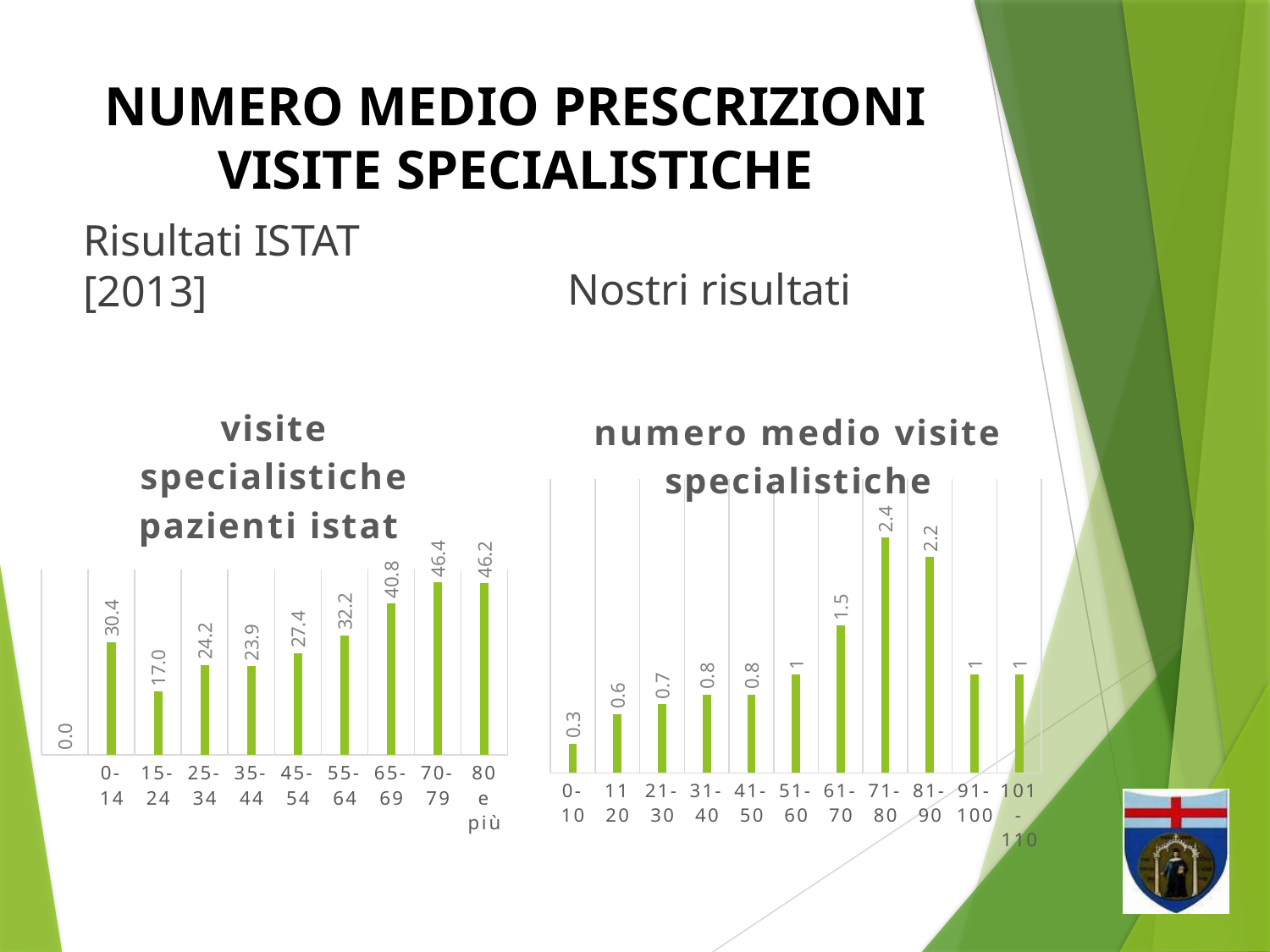
In the chart titled 'visite specialistiche pazienti istat', what is the value for the 0-14 age group? 30.4 In the chart titled 'numero medio visite specialistiche', what is the difference between the values for 71-80 and 81-90? 0.2 In the chart titled 'visite specialistiche pazienti istat', what is the value for the 65-69 age group? 40.8 What kind of chart is the chart titled 'numero medio visite specialistiche'? Bar chart In the chart titled 'numero medio visite specialistiche', what is the value for the 0-10 group? 0.3 In the chart titled 'numero medio visite specialistiche', what is the value for the 61-70 group? 1.5 In the chart titled 'visite specialistiche pazienti istat', what is the difference between the values for 70-79 and 0-14? 16.0 In the chart titled 'visite specialistiche pazienti istat', which labelled age group has the lowest value? 15-24 In the chart titled 'numero medio visite specialistiche', how many groups are shown on the x axis? 11 In the chart titled 'numero medio visite specialistiche', do the values rise or fall from the 0-10 group to the 71-80 group? Rise In the chart titled 'visite specialistiche pazienti istat', which is larger: the value for 25-34 or the value for 45-54? 45-54 In the chart titled 'numero medio visite specialistiche', which group has the highest value? 71-80